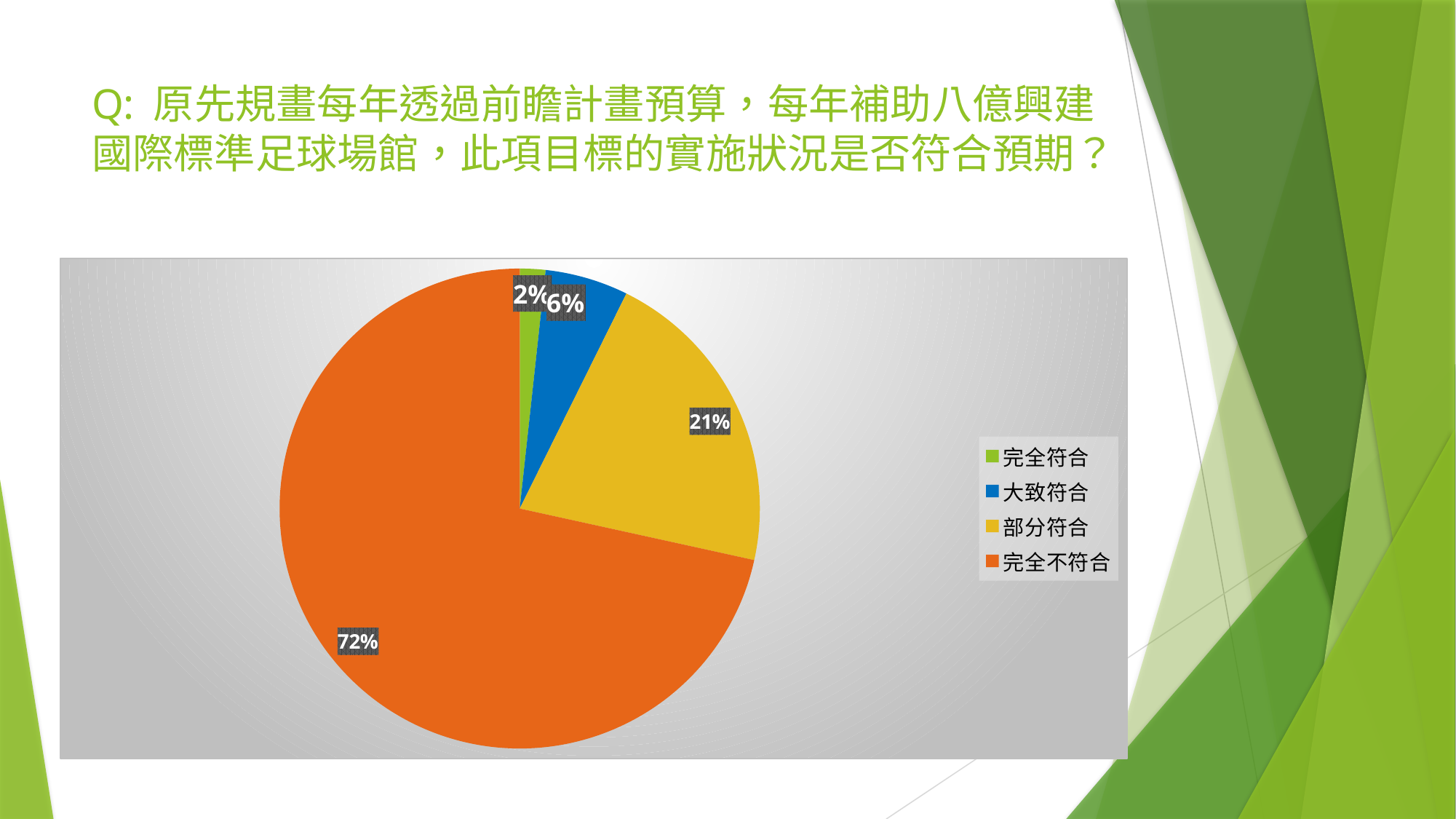
How many categories does the legend list? 4 Which category has the largest share of the pie? 完全不符合 What is the difference in percentage points between 完全不符合 and 部分符合? 51 What percentage of the pie is labelled 完全符合? 2% What colour is the slice for 大致符合? blue What percentage of the pie is labelled 大致符合? 6% What percentage of the pie is labelled 完全不符合? 72% Which category has the smallest share of the pie? 完全符合 What type of chart is shown on the slide? pie chart Which is larger, the share for 大致符合 or the share for 部分符合? 部分符合 What percentage of the pie is labelled 部分符合? 21% What is the combined share of 完全符合 and 大致符合? 8%